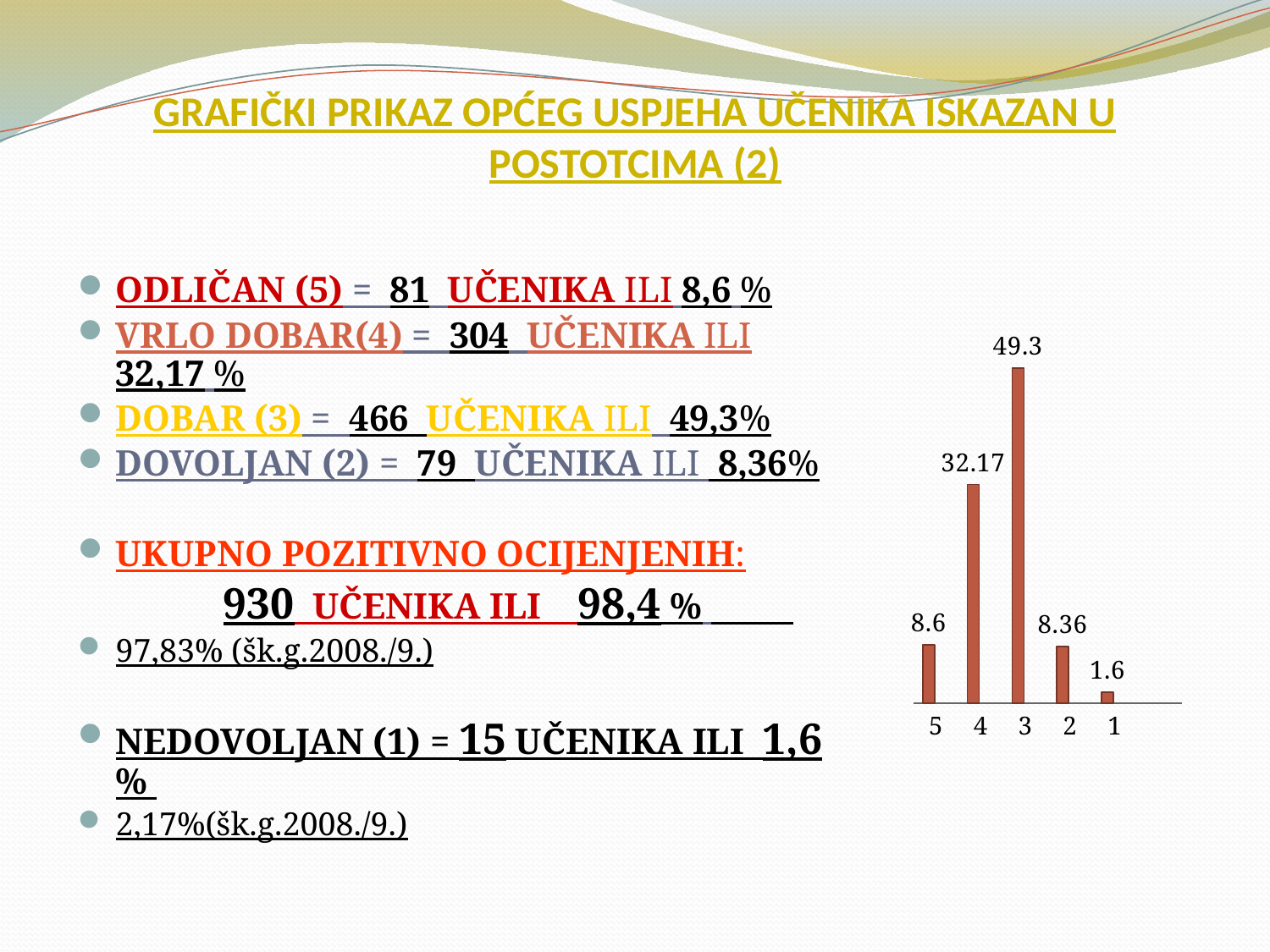
What is the value shown for category 1 in the bar chart? 1.6 What type of chart is shown on the slide? bar chart What is the total of the values for categories 5, 4, 3 and 2 in the bar chart? 98.43 What is the difference between the values for category 3 and category 4 in the bar chart? 17.13 Which category has the lowest value in the bar chart? 1 What is the value shown for category 4 in the bar chart? 32.17 What is the value shown for category 3 in the bar chart? 49.3 Which category has the highest value in the bar chart? 3 What is the difference between the values for category 5 and category 2 in the bar chart? 0.24 Which is larger in the bar chart, the value for category 4 or the value for category 5? 4 How many categories are shown on the x axis of the bar chart? 5 What is the value shown for category 2 in the bar chart? 8.36